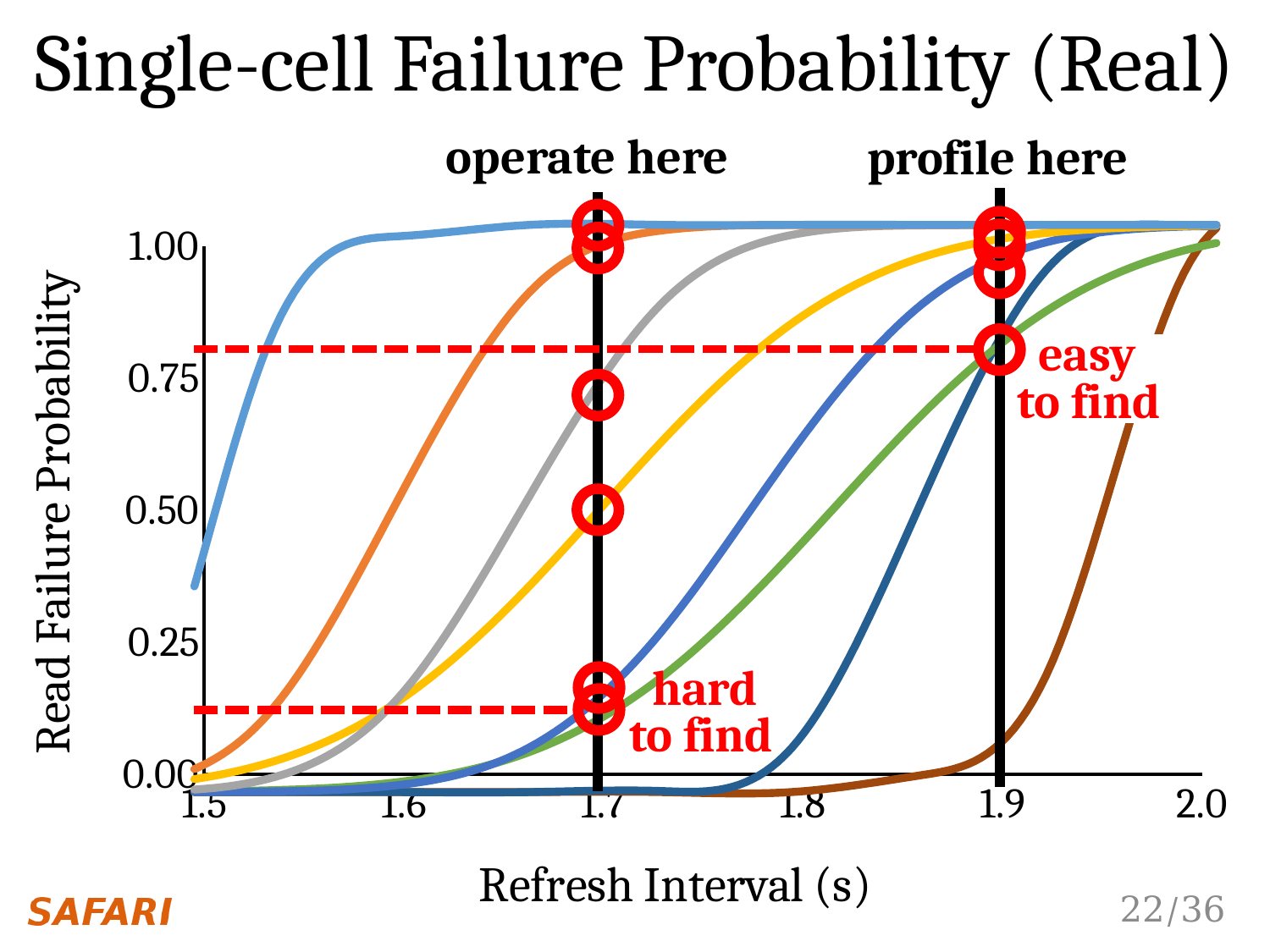
Is the value of the light blue curve at a refresh interval of 1.6 s greater or less than 0.75? greater Is the value of the dark blue curve at a refresh interval of 1.7 s greater or less than 0.25? less What kind of chart is shown on the slide? line chart How many curves are plotted on the chart? 8 Is the value of the orange curve at a refresh interval of 1.7 s greater or less than 0.75? greater At which refresh interval is the vertical line labelled "operate here" drawn? 1.7 What is the title of the chart? Single-cell Failure Probability (Real) Do the curves rise or fall as the refresh interval increases along the x axis? rise At a refresh interval of 1.9 s, which curve has the lower read failure probability, the brown curve or the yellow curve? brown At a refresh interval of 1.7 s, which curve has the larger read failure probability, the orange curve or the green curve? orange